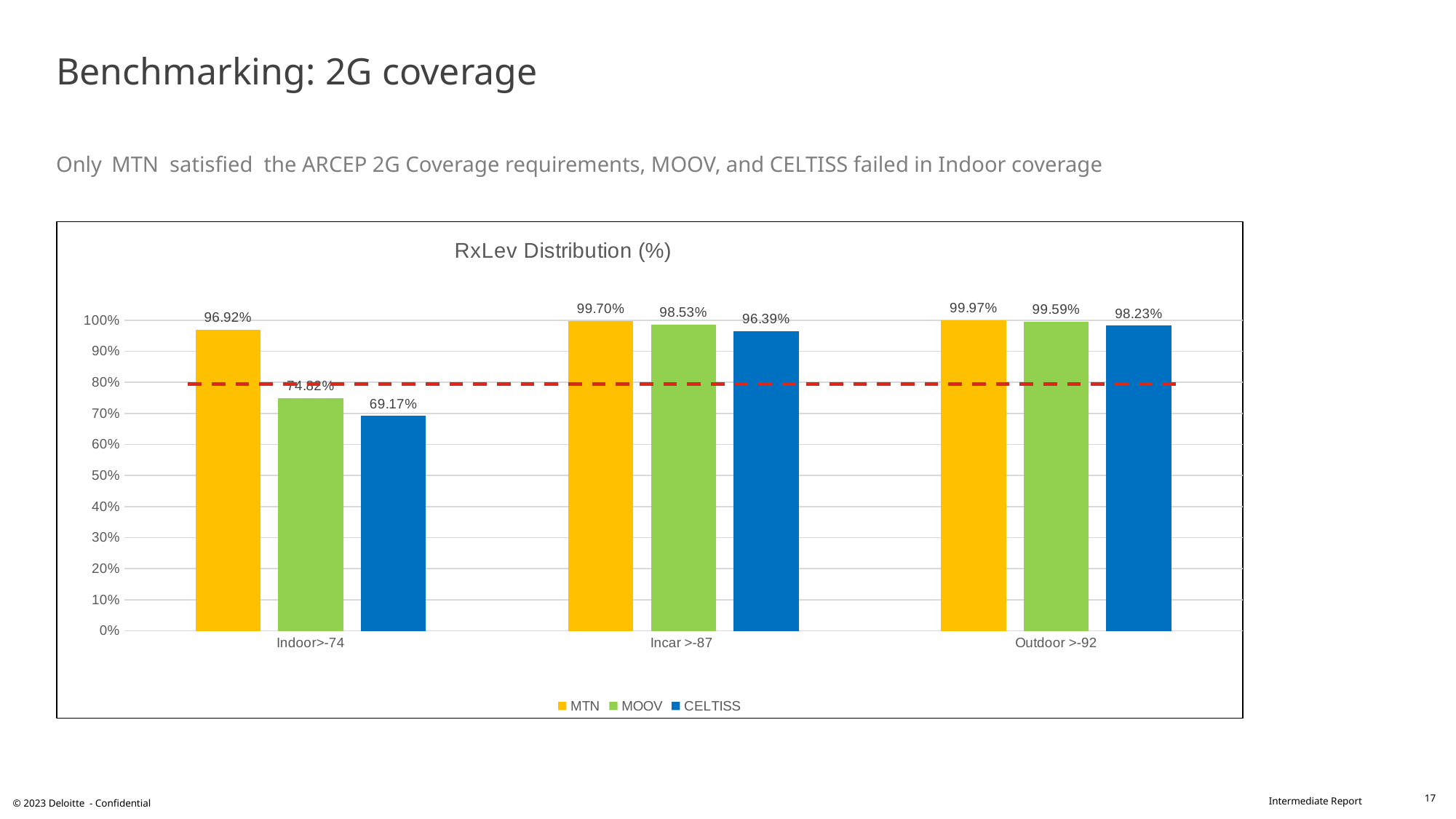
How many series does the legend list? 3 What is the value for CELTISS in the Indoor>-74 category? 69.17% What type of chart is shown on the slide? Bar chart What is the difference between the MTN and CELTISS values in the Indoor>-74 category? 27.75 percentage points Which series has the highest value in the Incar >-87 category? MTN What is the value for MTN in the Indoor>-74 category? 96.92% What is the value for MTN in the Outdoor >-92 category? 99.97% What is the value for MOOV in the Incar >-87 category? 98.53% Which series has the lowest value in the Indoor>-74 category? CELTISS Is the value for CELTISS in the Indoor>-74 category greater or less than 80%? less How many categories are shown on the x axis? 3 What is the title of the chart? RxLev Distribution (%)